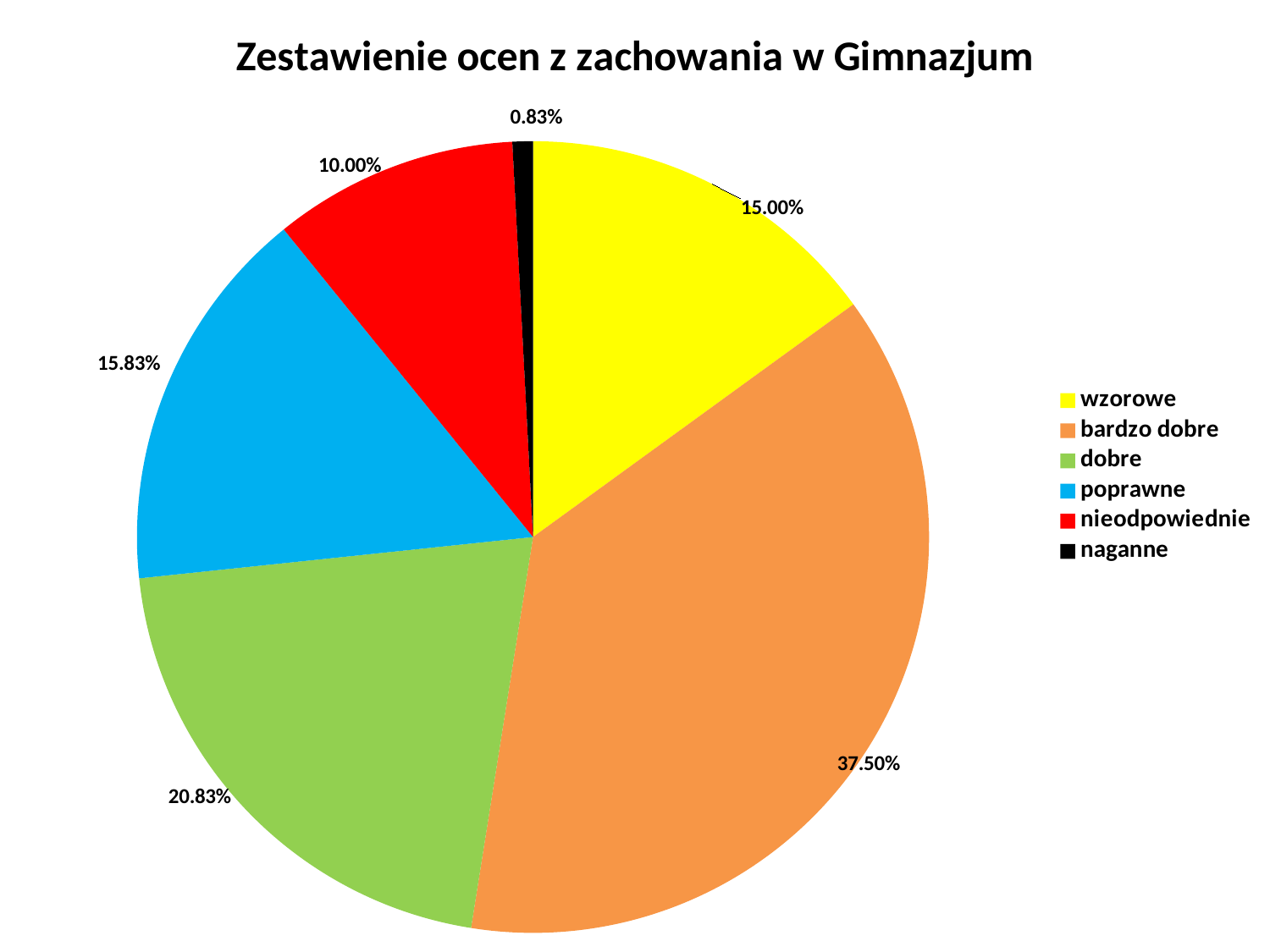
Which category has the largest slice of the pie? bardzo dobre What share of the pie does the 'bardzo dobre' slice represent? 37.50% What share of the pie does the 'poprawne' slice represent? 15.83% Which slice is larger, 'nieodpowiednie' or 'poprawne'? poprawne What is the difference in percentage points between the 'bardzo dobre' and 'dobre' slices? 16.67 What share of the pie does the 'naganne' slice represent? 0.83% What colour is the 'nieodpowiednie' slice? red What kind of chart is shown on the slide? pie chart Which category has the smallest slice of the pie? naganne How many categories does the pie chart show? 6